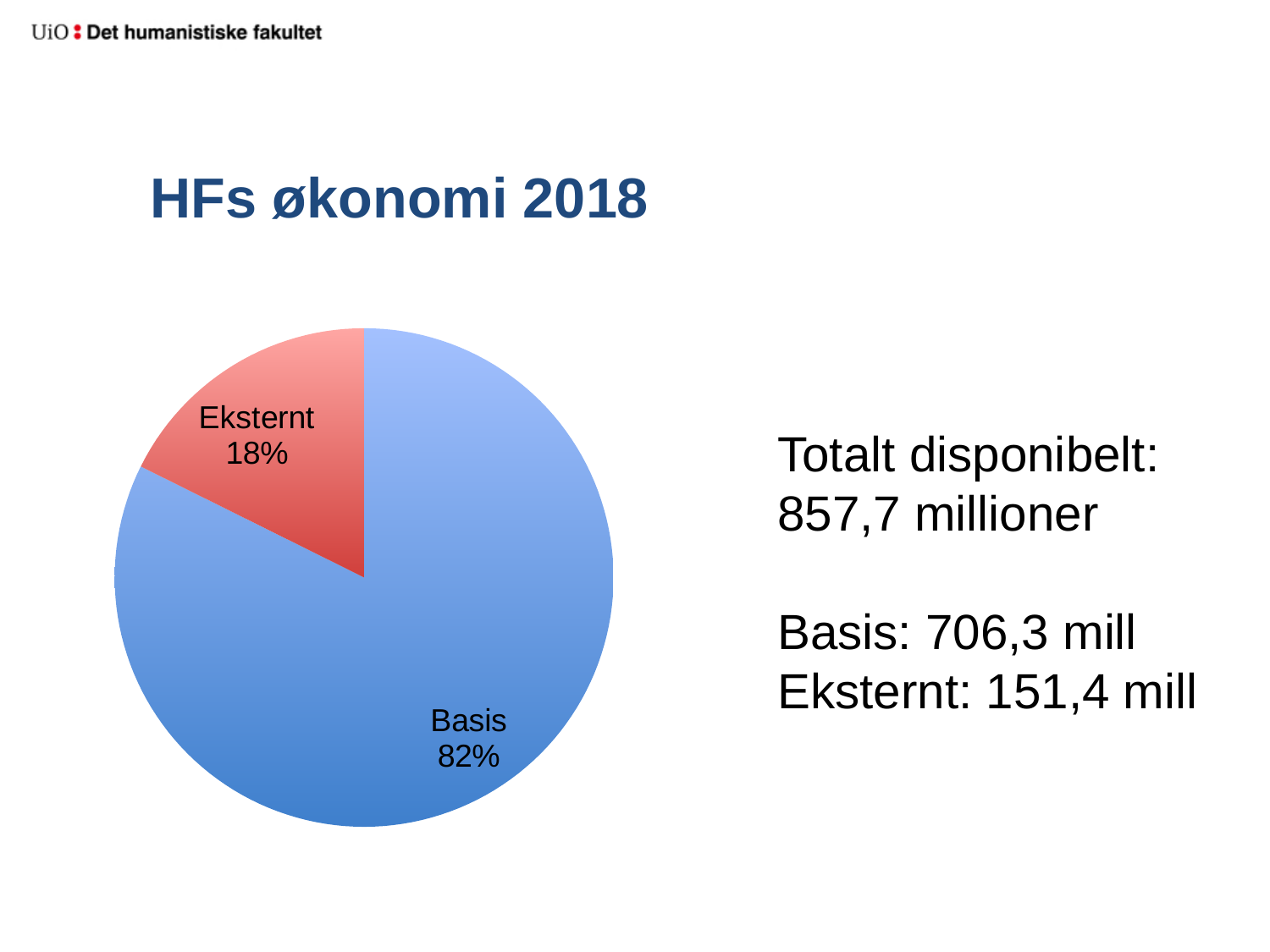
How many slices does the pie chart have? 2 What colour is the Eksternt slice of the pie? red Which slice of the pie is the smallest? Eksternt Which is larger, the Basis slice or the Eksternt slice? Basis What share of the pie does Basis represent? 82% Is the share for Basis greater or less than 50%? greater What kind of chart is shown on the slide? pie chart What is the title of the slide containing the pie chart? HFs økonomi 2018 What is the difference in percentage points between the Basis and Eksternt slices? 64 Which slice of the pie is the largest? Basis What share of the pie does Eksternt represent? 18%